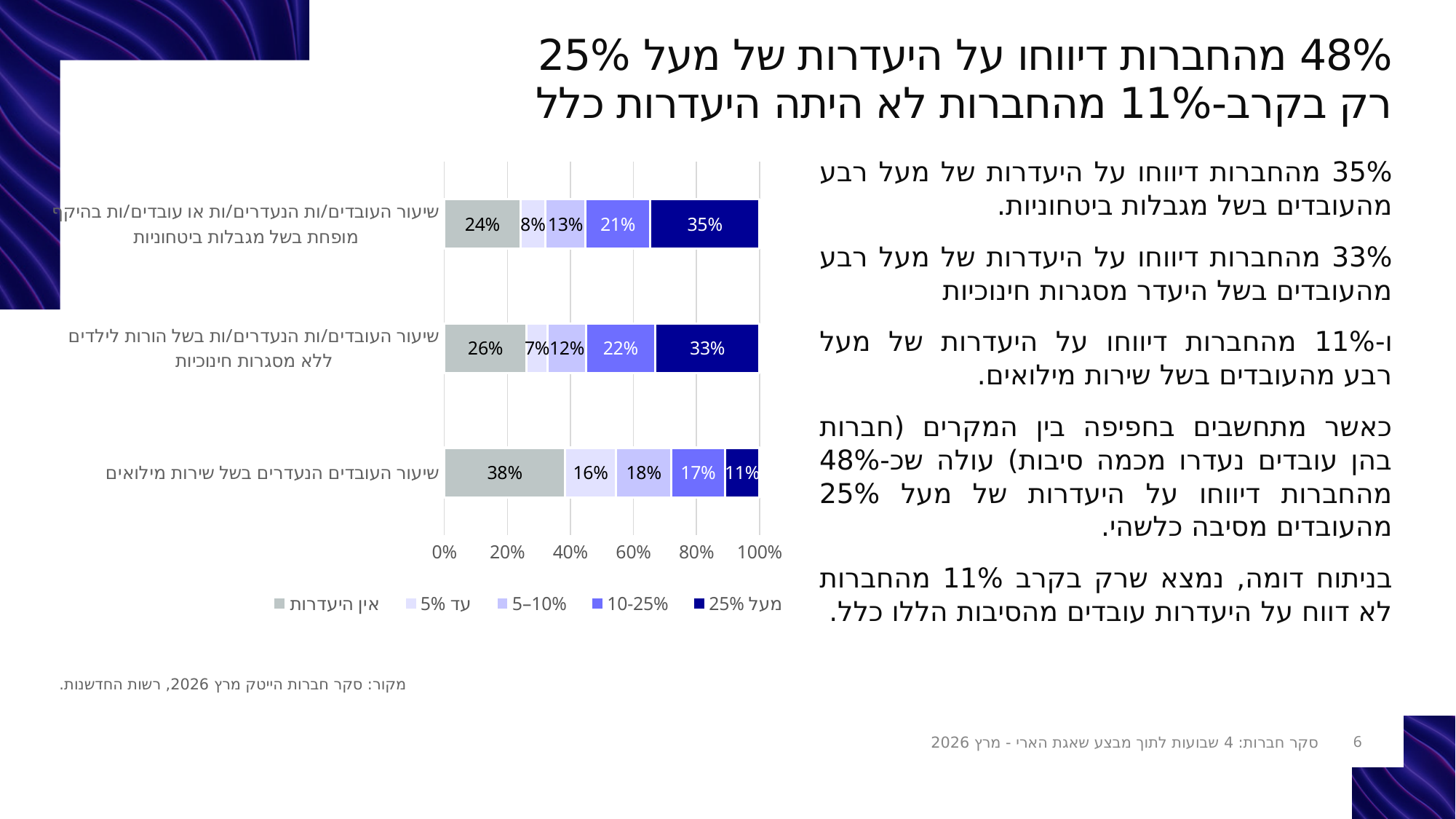
Which category has the highest value for the 'אין היעדרות' series? שיעור העובדים הנעדרים בשל שירות מילואים What is the total of the stacked bar for the category 'שיעור העובדים הנעדרים בשל שירות מילואים'? 100% What kind of chart is shown on the slide? stacked bar chart What is the difference between the 'מעל 25%' values for the 'מגבלות ביטחוניות' category and the 'שירות מילואים' category? 24% How many series does the legend list? 5 What is the value of the 'אין היעדרות' segment for the category 'שיעור העובדים/ות הנעדרים/ות בשל הורות לילדים ללא מסגרות חינוכיות'? 26% How many categories (bars) does the chart show? 3 Which legend entry is shown in the darkest blue colour? מעל 25% What is the value of the 'מעל 25%' segment for the category 'שיעור העובדים הנעדרים בשל שירות מילואים'? 11% What is the value of the '10-25%' segment for the category 'שיעור העובדים/ות הנעדרים/ות או עובדים/ות בהיקף מופחת בשל מגבלות ביטחוניות'? 21% Which category has the lowest value for the 'מעל 25%' series? שיעור העובדים הנעדרים בשל שירות מילואים Which is larger: the 'עד 5%' value for the 'שירות מילואים' category or the 'עד 5%' value for the 'מגבלות ביטחוניות' category? שירות מילואים (16%)